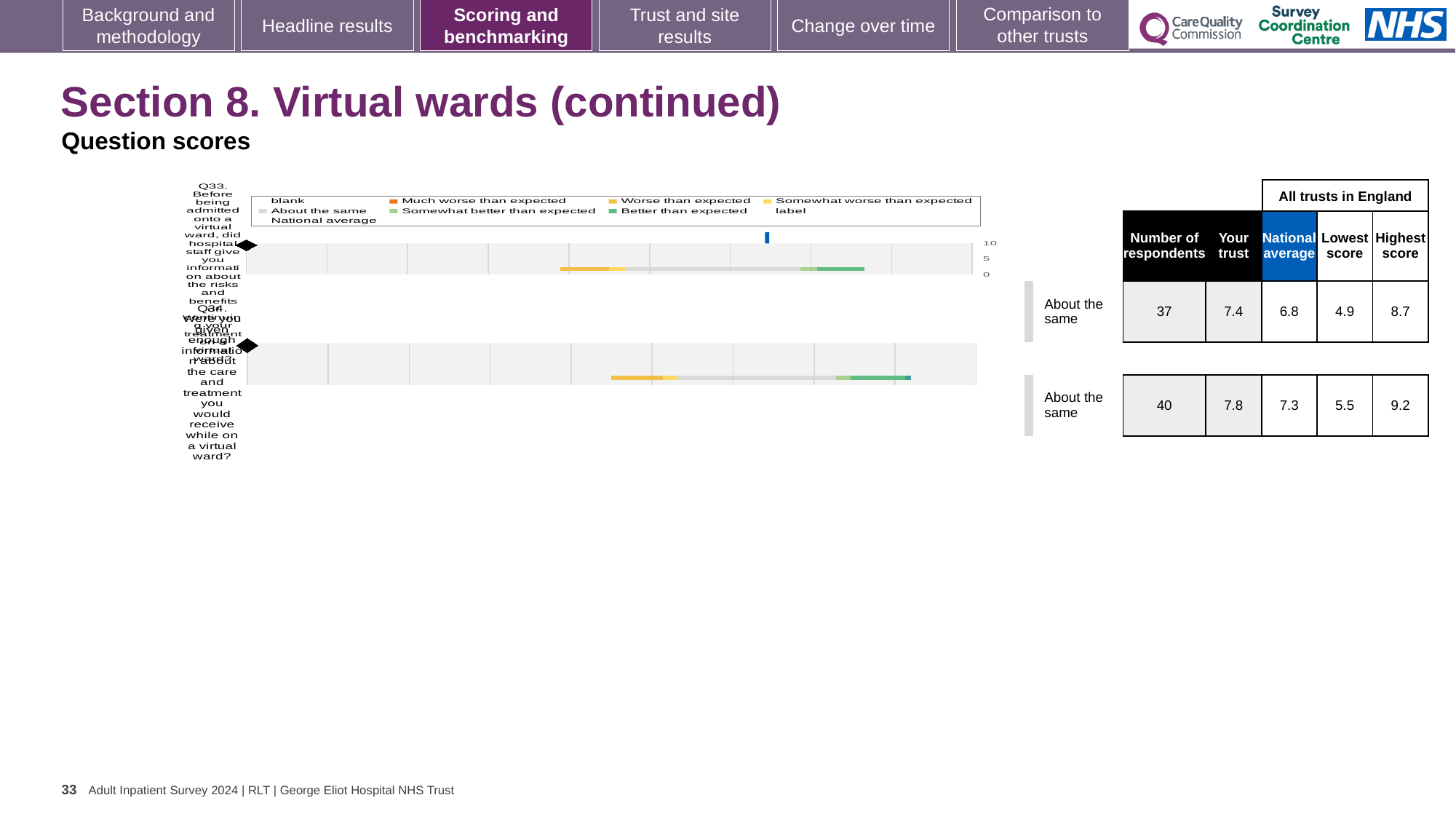
What is the highest score among all trusts in England for Q34? 9.2 How many questions (bars) are plotted in the chart? 2 What is the national average score for Q33? 6.8 What is the 'Your trust' score for Q33 (information about the risks and benefits of a virtual ward)? 7.4 What kind of chart is shown on the slide? bar chart What is the difference between the 'Your trust' score and the national average for Q34? 0.5 How many respondents answered Q34 (enough information about care and treatment on a virtual ward)? 40 What is the 'Your trust' score for Q34? 7.8 What benchmark category is shown for both Q33 and Q34? About the same What is the lowest score among all trusts in England for Q33? 4.9 Which colour in the legend represents 'Better than expected'? green For Q33, which is larger: the 'Your trust' score or the national average? Your trust